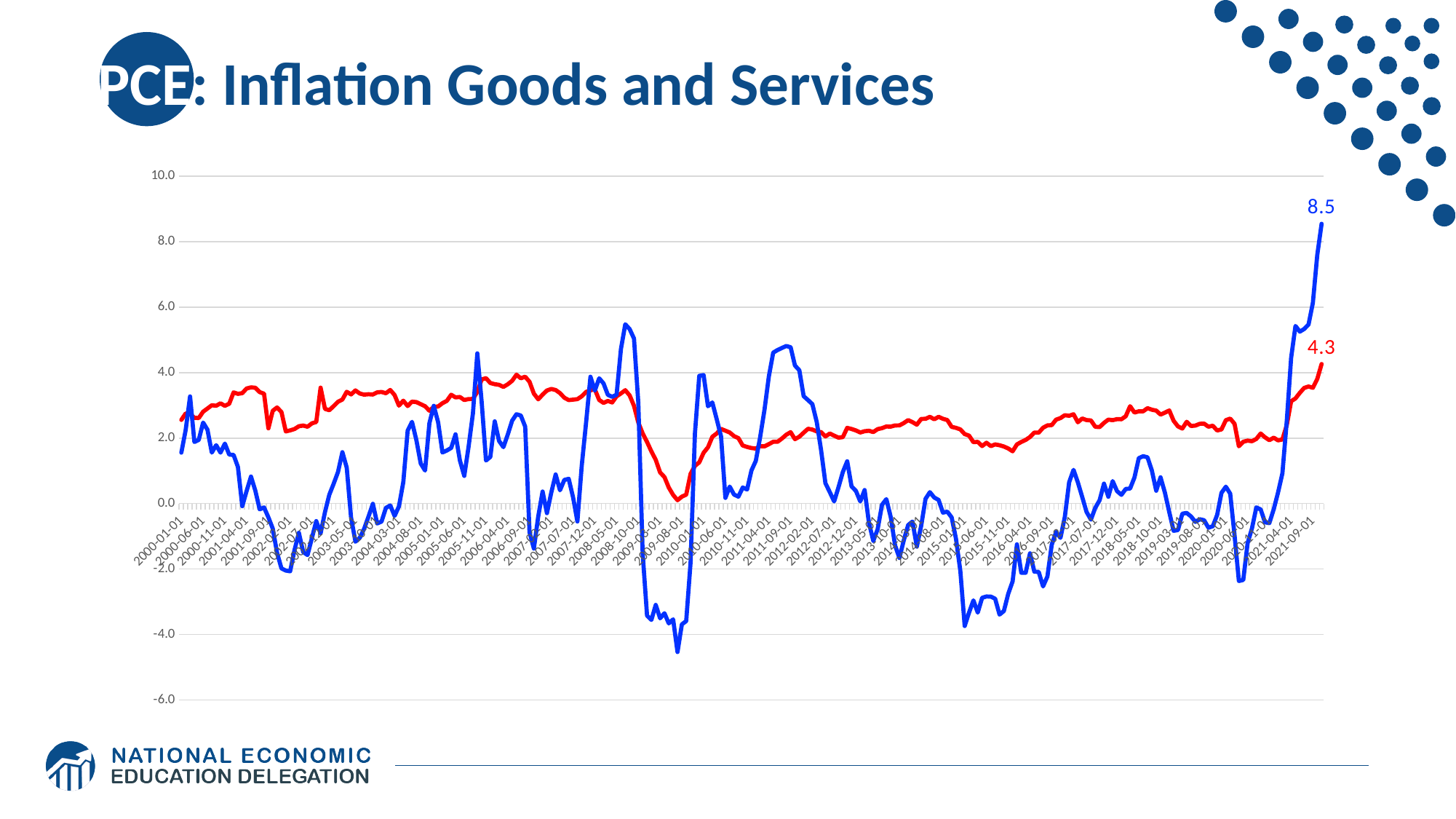
What is the difference between the labelled final values of the blue line (8.5) and the red line (4.3)? 4.2 What is the highest value shown on the vertical axis? 10.0 Is the value of the red line at its low point around 2009-08-01 greater or less than 1.0? less What is the title of the chart on the slide? PCE: Inflation Goods and Services What kind of chart is shown on the slide? line chart Does the blue line rise or fall between 2020-06-01 and 2021-09-01? rise What is the labelled final value of the blue line? 8.5 Is the lowest point of the blue line, around 2009, greater or less than -4.0? less What is the labelled final value of the red line? 4.3 How many lines are plotted on the chart? 2 Which line ends at a higher value at the right edge of the chart, the blue line or the red line? blue line Is the value of the red line at 2000-01-01 greater or less than 2.0? greater